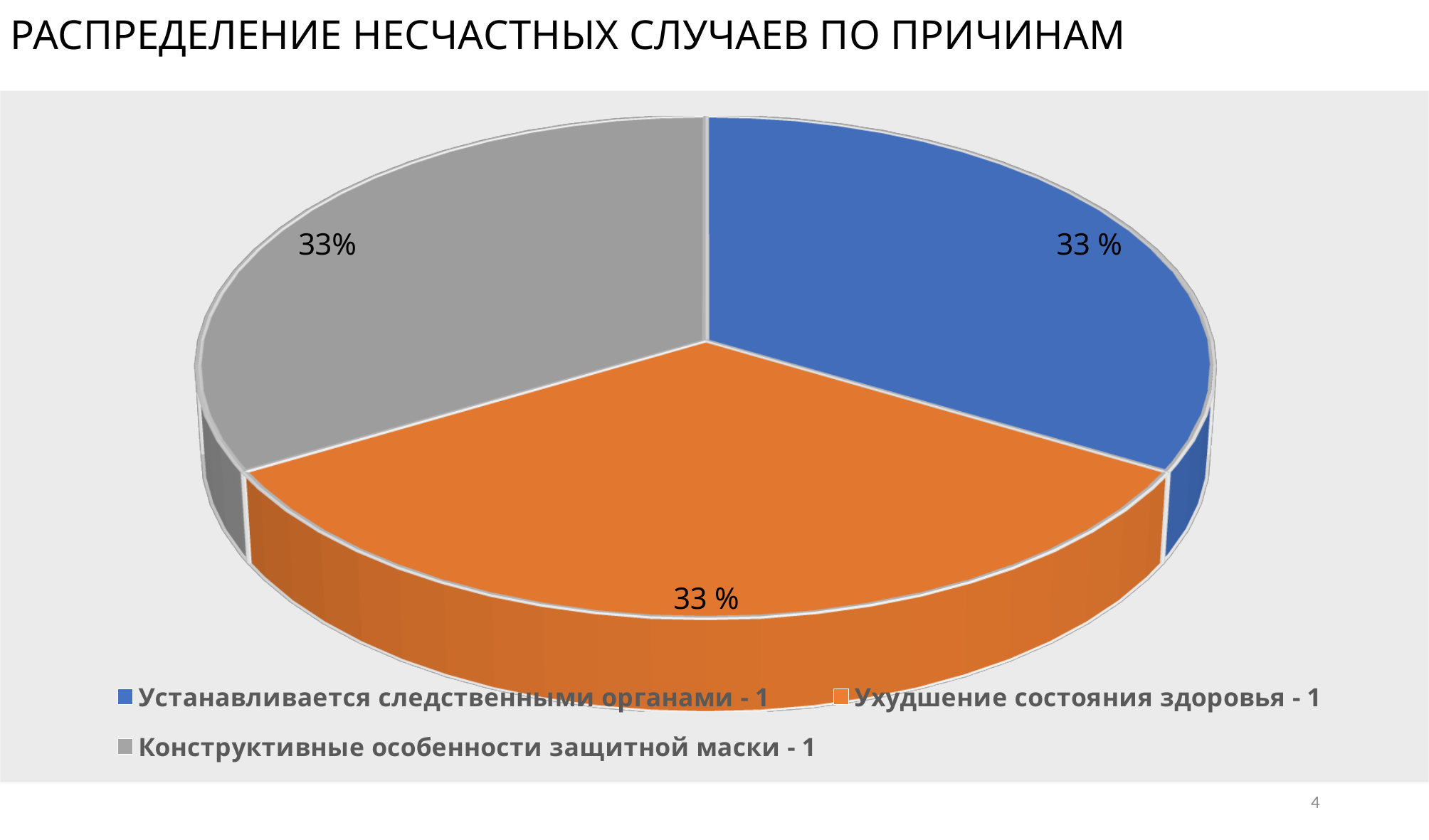
What share of the pie is labelled for the slice "Ухудшение состояния здоровья - 1"? 33 % What share of the pie is labelled for the slice "Устанавливается следственными органами - 1"? 33 % How many slices does the pie chart have? 3 How many entries does the legend list? 3 Is the share for "Устанавливается следственными органами - 1" greater or less than 25%? greater What kind of chart is shown on the slide? Pie chart Is the share for "Конструктивные особенности защитной маски - 1" greater or less than 50%? less What share of the pie is labelled for the slice "Конструктивные особенности защитной маски - 1"? 33% What is the title of the chart on the slide? РАСПРЕДЕЛЕНИЕ НЕСЧАСТНЫХ СЛУЧАЕВ ПО ПРИЧИНАМ Which colour represents "Ухудшение состояния здоровья - 1" in the pie chart? Orange